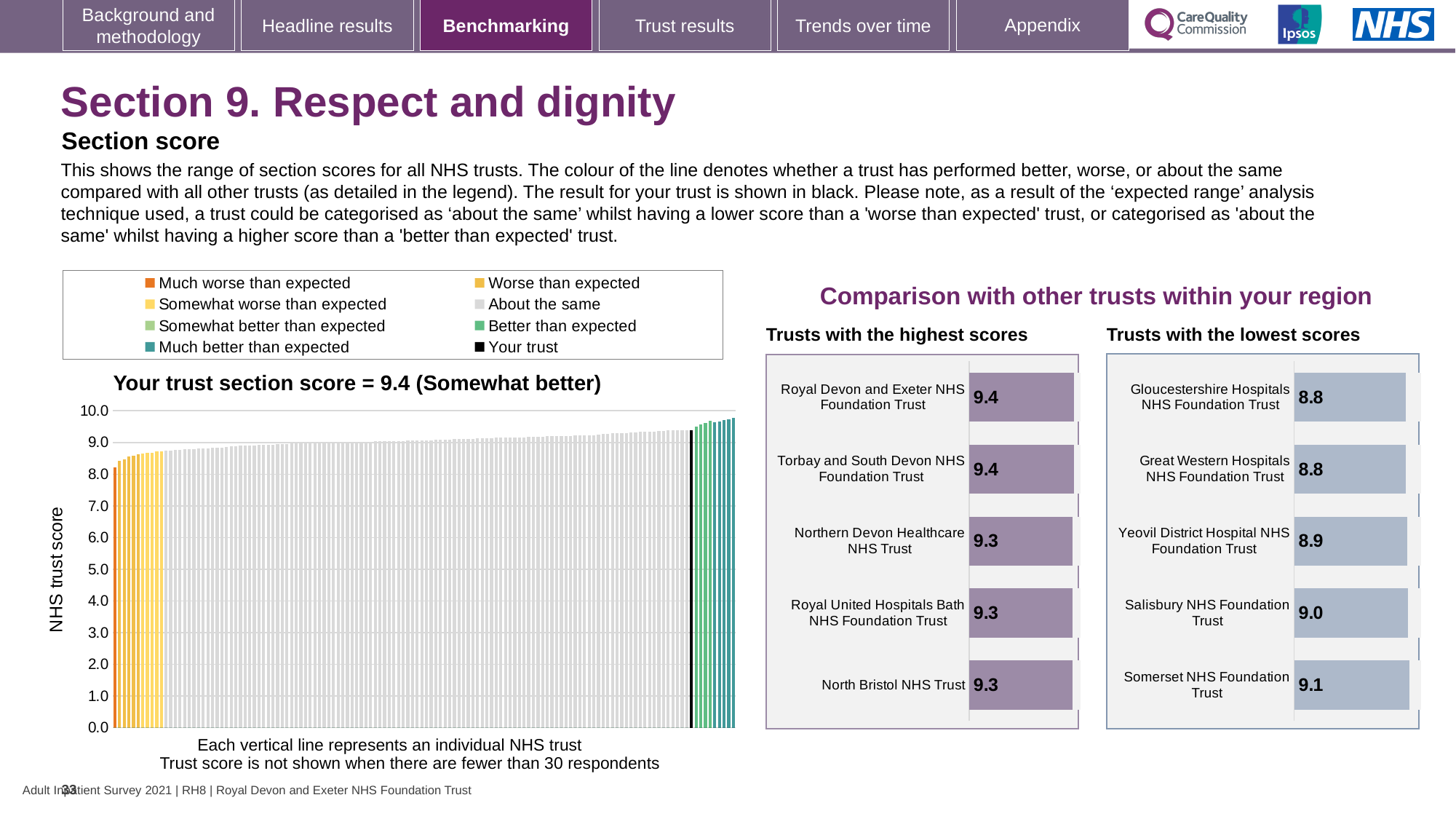
According to the title of the chart on the left, what is your trust's section score? 9.4 What is the y-axis label of the 'Your trust section score' chart on the left? NHS trust score What kind of chart is the 'Your trust section score' chart on the left of the slide? bar chart In the 'Trusts with the highest scores' chart, what is the score for North Bristol NHS Trust? 9.3 In the 'Trusts with the lowest scores' chart, which has the larger score: Salisbury NHS Foundation Trust or Yeovil District Hospital NHS Foundation Trust? Salisbury NHS Foundation Trust In the 'Trusts with the lowest scores' chart, which trust has the highest score? Somerset NHS Foundation Trust How many trusts are listed in the 'Trusts with the highest scores' chart? 5 In the 'Your trust section score' chart on the left, do the values rise or fall from left to right along the x axis? rise In the 'Trusts with the lowest scores' chart, how much higher is Somerset NHS Foundation Trust's score than Gloucestershire Hospitals NHS Foundation Trust's score? 0.3 In the 'Trusts with the highest scores' chart, what is the difference between the scores of Royal Devon and Exeter NHS Foundation Trust and North Bristol NHS Trust? 0.1 How many entries does the legend above the 'Your trust section score' chart list? 8 In the 'Trusts with the lowest scores' chart, what is the score for Somerset NHS Foundation Trust? 9.1